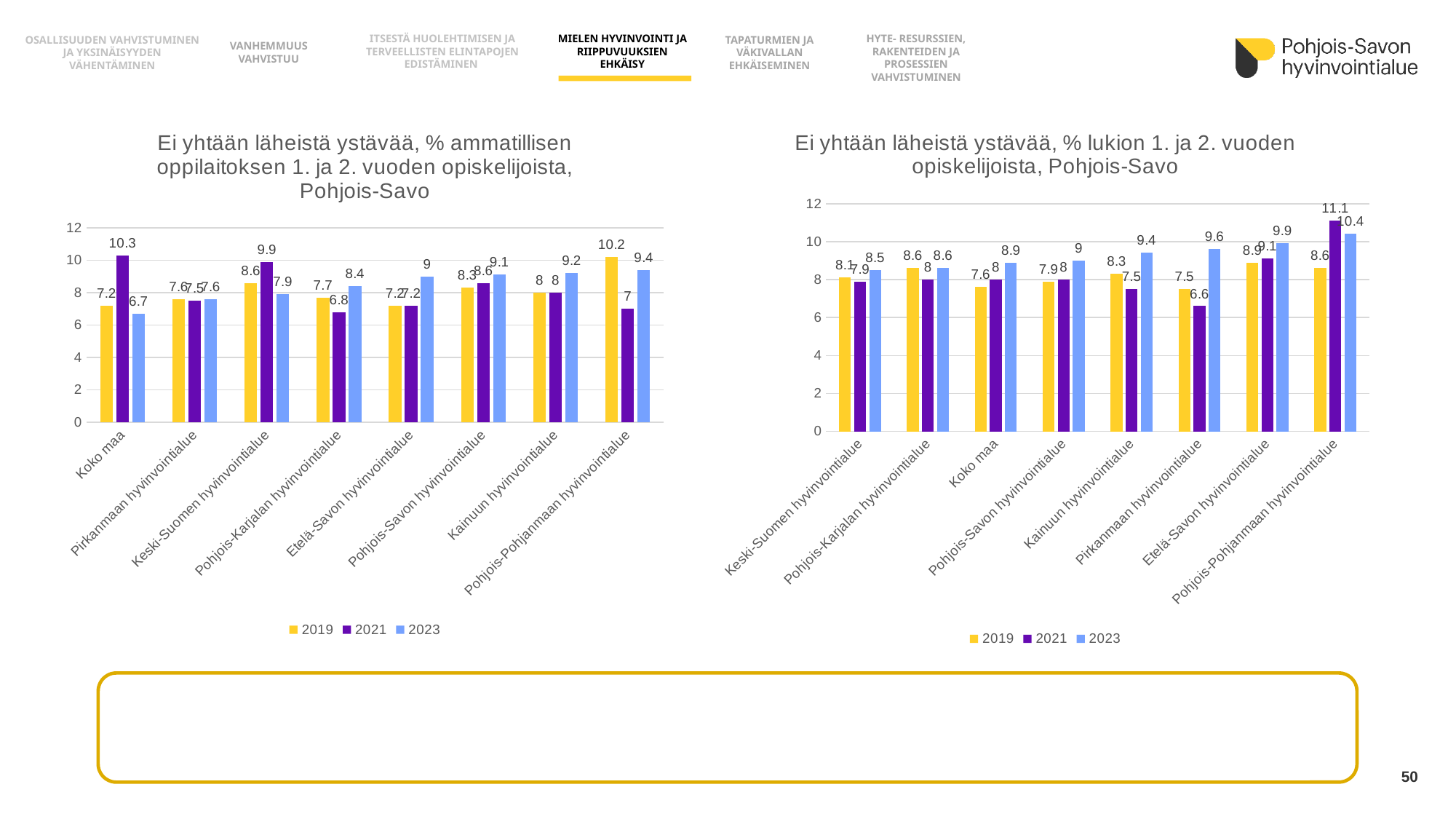
In the left chart (ammatillisen oppilaitoksen), what is the difference between the 2021 and 2023 values for Koko maa? 3.6 In the left chart (ammatillisen oppilaitoksen), how many categories are shown on the x axis? 8 In the left chart (ammatillisen oppilaitoksen), what is the 2021 value for Koko maa? 10.3 How many series does the legend of the right chart (lukion) list? 3 In the left chart (ammatillisen oppilaitoksen), which category has the lowest 2021 value? Pohjois-Karjalan hyvinvointialue In the right chart (lukion), what is the difference between the 2023 and 2019 values for Pirkanmaan hyvinvointialue? 2.1 In the left chart (ammatillisen oppilaitoksen), what is the 2023 value for Pohjois-Savon hyvinvointialue? 9.1 In the right chart (lukion), what is the 2021 value for Pohjois-Pohjanmaan hyvinvointialue? 11.1 In the left chart (ammatillisen oppilaitoksen), which category has the highest 2019 value? Pohjois-Pohjanmaan hyvinvointialue In the right chart (lukion), which is larger for Kainuun hyvinvointialue: the 2019 value or the 2023 value? 2023 What type of chart is the left chart (ammatillisen oppilaitoksen)? Bar chart In the right chart (lukion), which category has the lowest 2021 value? Pirkanmaan hyvinvointialue